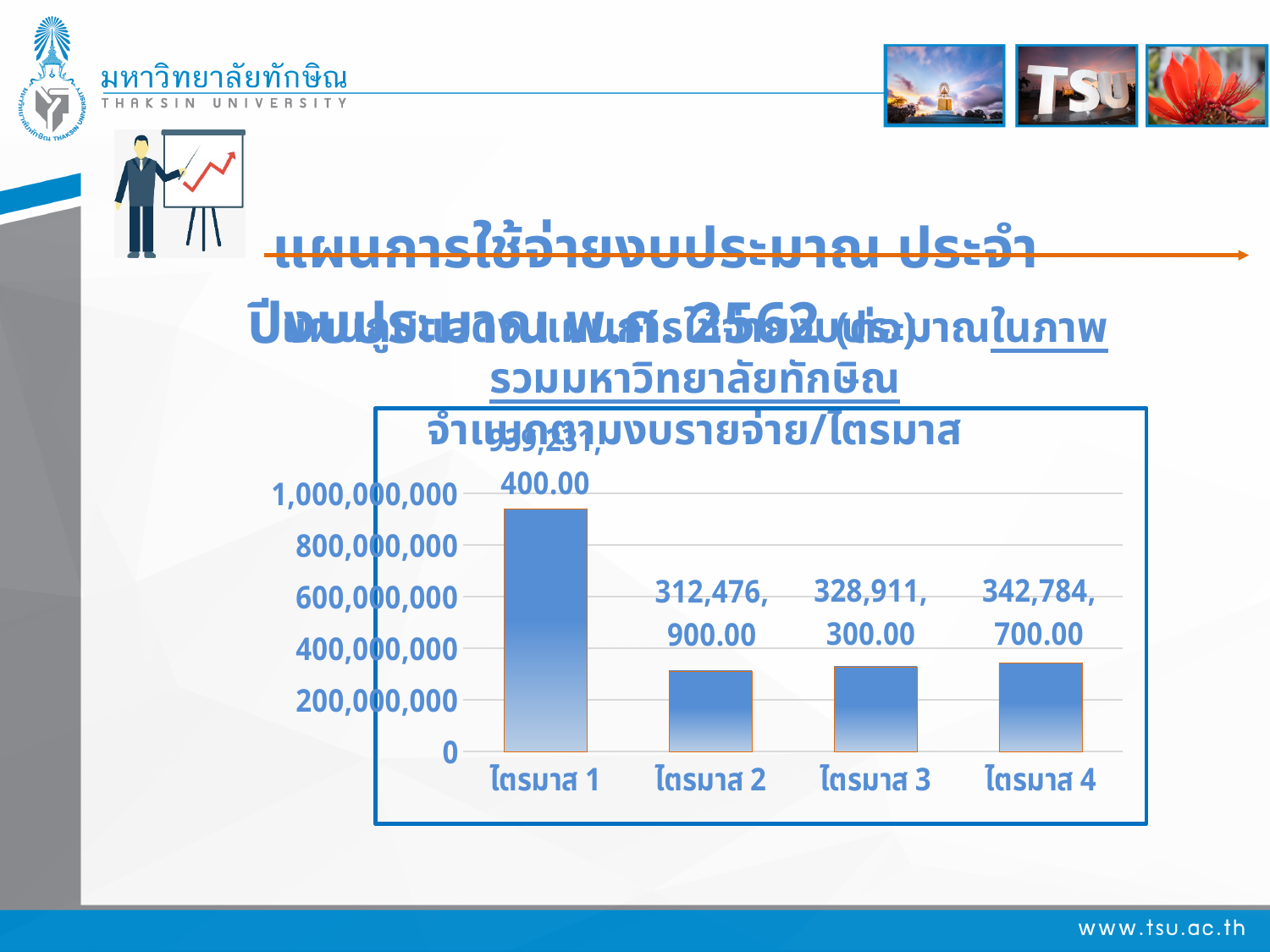
What kind of chart is shown on the slide? bar chart What is the difference between the values for ไตรมาส 4 and ไตรมาส 2? 30,307,800.00 What is the value for ไตรมาส 2? 312,476,900.00 What is the value for ไตรมาส 4? 342,784,700.00 From ไตรมาส 2 to ไตรมาส 4, do the values rise or fall? rise Which is larger, the value for ไตรมาส 3 or ไตรมาส 4? ไตรมาส 4 What is the difference between the values for ไตรมาส 3 and ไตรมาส 2? 16,434,400.00 What is the value for ไตรมาส 3? 328,911,300.00 How many quarters are shown on the x axis? 4 Is the value for ไตรมาส 1 greater or less than 800,000,000? greater Which quarter has the lowest value? ไตรมาส 2 Which quarter has the highest value? ไตรมาส 1